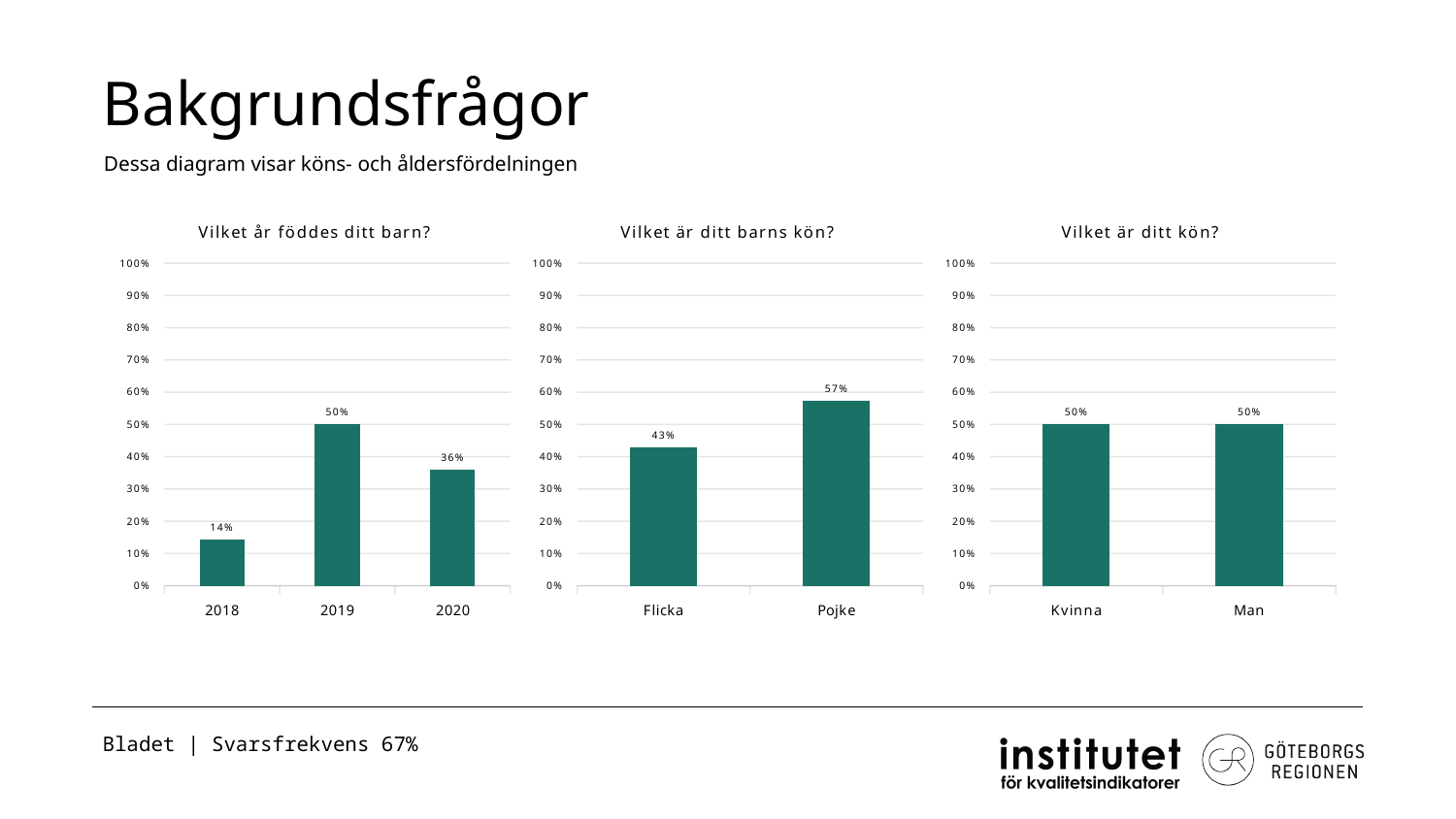
In the chart titled "Vilket år föddes ditt barn?", which year has the lowest value? 2018 In the chart titled "Vilket år föddes ditt barn?", is the value for 2018 greater or less than 20%? less In the chart titled "Vilket är ditt barns kön?", which category has the highest value? Pojke In the chart titled "Vilket är ditt kön?", is the value for Man greater or less than 40%? greater In the chart titled "Vilket år föddes ditt barn?", what is the difference between the values for 2019 and 2020? 14% How many charts are shown on the slide? 3 In the chart titled "Vilket är ditt barns kön?", what is the difference between the values for Pojke and Flicka? 14% What kind of chart is the chart titled "Vilket är ditt barns kön?"? bar chart In the chart titled "Vilket är ditt kön?", what is the value for Kvinna? 50% In the chart titled "Vilket är ditt barns kön?", what is the value for Pojke? 57% In the chart titled "Vilket år föddes ditt barn?", what is the value for 2019? 50% In the chart titled "Vilket år föddes ditt barn?", how many categories are shown on the x axis? 3